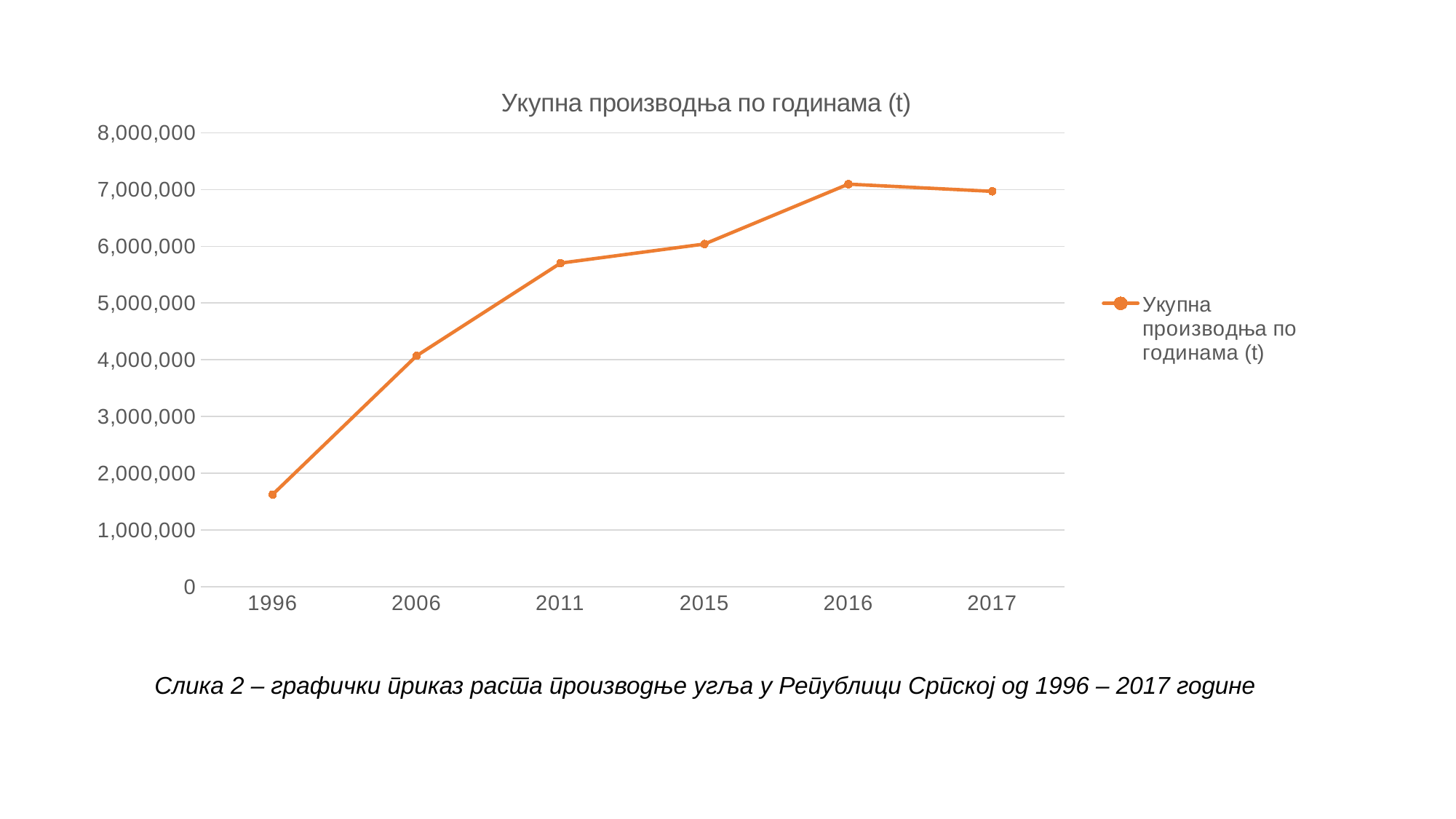
What kind of chart is shown on the slide? line chart How many years are plotted on the x axis? 6 How many series does the legend list? 1 Is the value for 2017 greater or less than 6,000,000? greater Which year has the lowest value? 1996 Is the value for 2011 greater or less than 6,000,000? less Is the value for 2006 greater or less than 3,000,000? greater Which is larger, the value for 2006 or the value for 2011? 2011 Do the values rise or fall from 1996 to 2016? rise What is the title of the chart? Укупна производња по годинама (t)